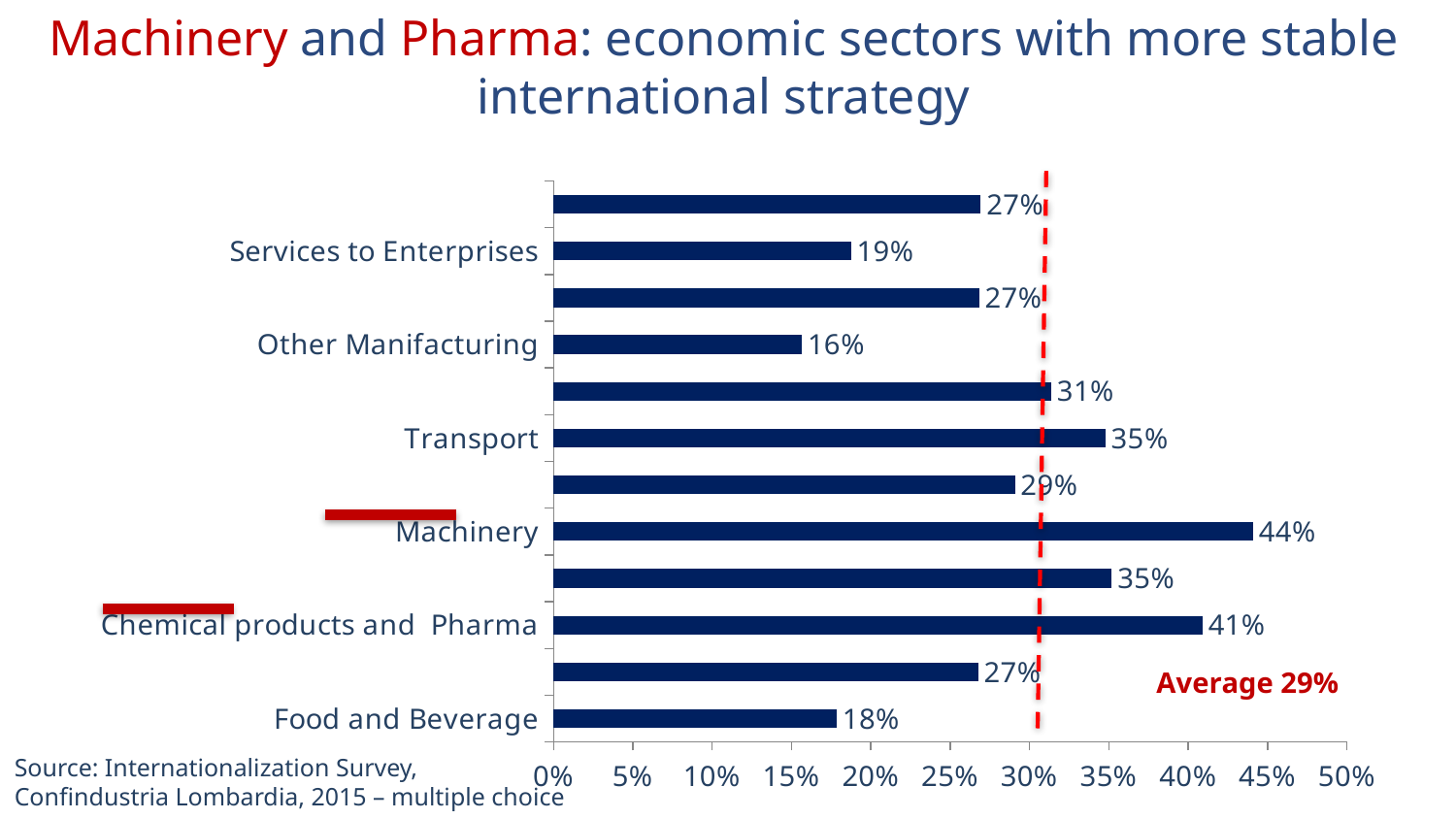
What average value is marked by the red dashed line? 29% What is the value for Services to Enterprises? 19% What kind of chart is shown on the slide? Bar chart What is the value for Food and Beverage? 18% What is the value for Transport? 35% What is the difference between the values for Machinery and Chemical products and Pharma? 3% Which is larger, the value for Transport or the value for Food and Beverage? Transport Which labeled sector has the highest value? Machinery What is the value for Chemical products and Pharma? 41% How many bars are plotted in the chart? 12 What is the value for Machinery? 44% Which labeled sector has the lowest value? Other Manifacturing